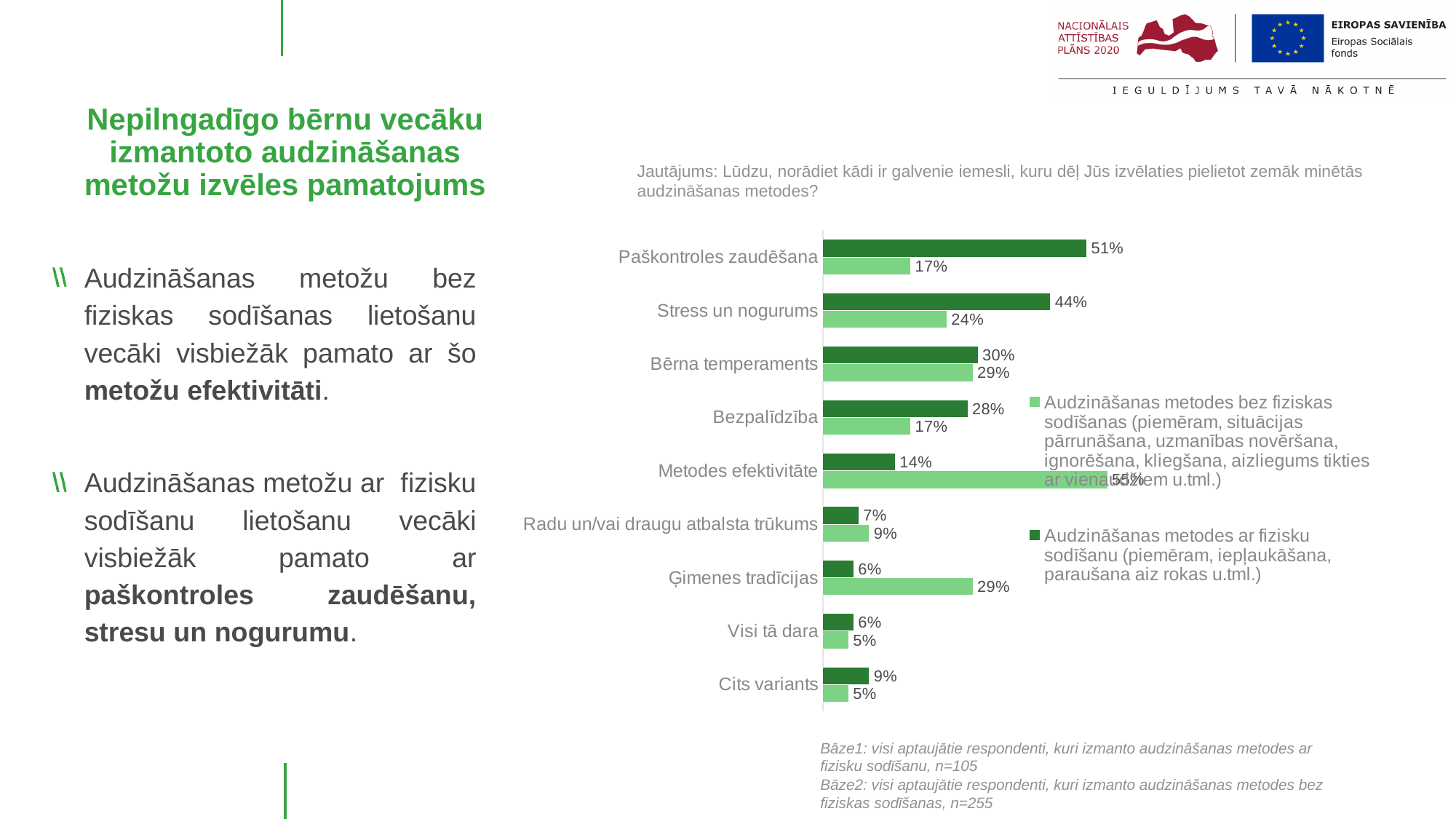
For "Bezpalīdzība", which series has the larger value: methods with physical punishment or methods without physical punishment? Methods with physical punishment How many categories are shown on the chart? 9 What percentage of parents using methods with physical punishment cite "Paškontroles zaudēšana"? 51% What percentage of parents using methods without physical punishment cite "Stress un nogurums"? 24% What type of chart is shown on the slide? Bar chart Which colour represents the series for methods with physical punishment? Dark green How many series does the legend list? 2 What is the value for "Cits variants" in the series for methods with physical punishment? 9% Which category has the highest value for methods with physical punishment? Paškontroles zaudēšana What is the value for "Ģimenes tradīcijas" in the series for methods without physical punishment? 29% Which category has the highest value for methods without physical punishment? Metodes efektivitāte What is the difference between the two series for "Paškontroles zaudēšana"? 34 percentage points